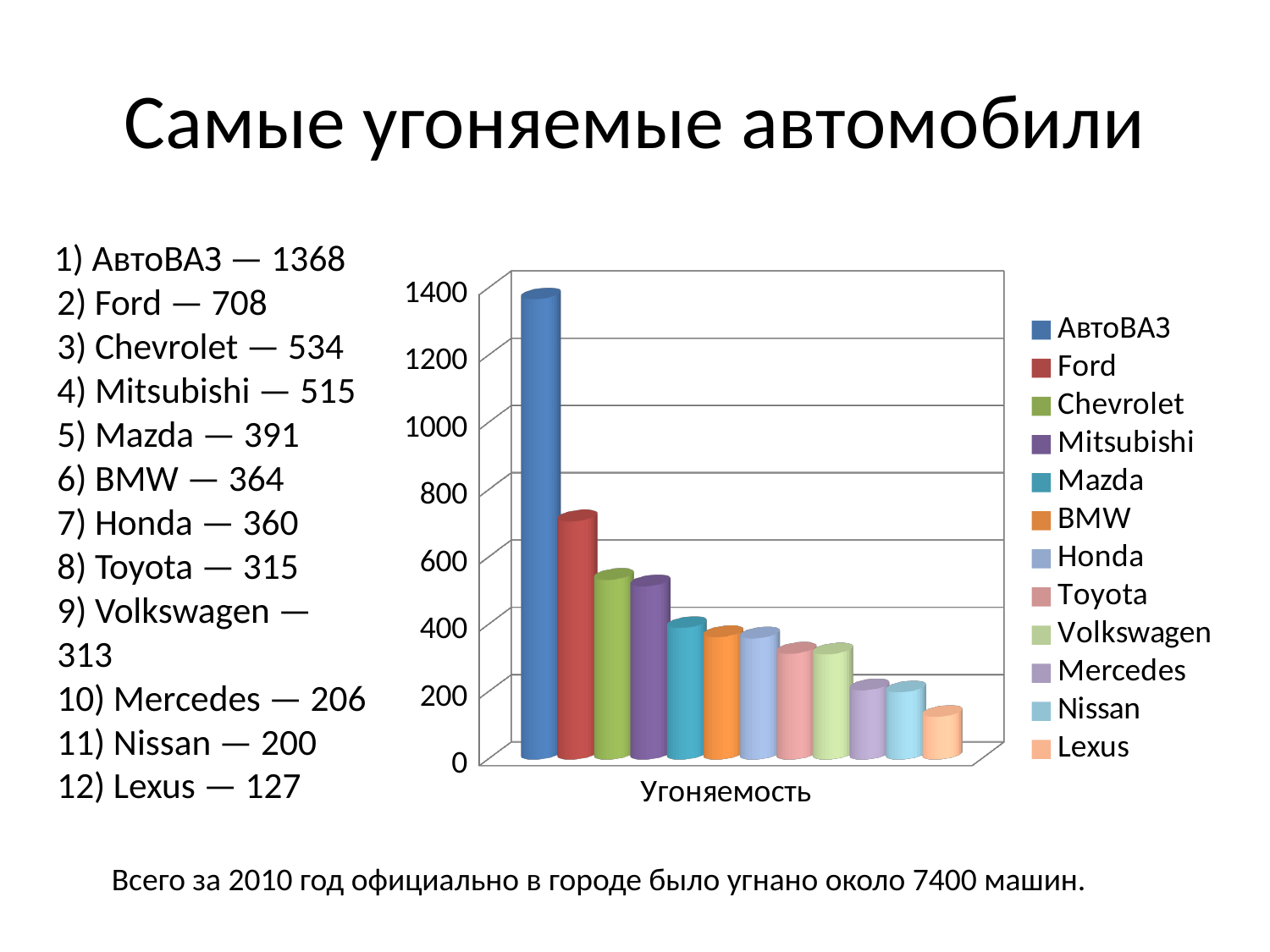
What kind of chart is shown on the slide? bar chart What is the value for Lexus? 127 Which is larger, the value for Chevrolet or the value for Mazda? Chevrolet What is the value for АвтоВАЗ? 1368 Is the value for Ford greater or less than 600? greater Is the value for Nissan greater or less than 400? less How many series does the chart legend list? 12 Which car brand has the highest value in the chart? АвтоВАЗ Which car brand has the lowest value in the chart? Lexus What is the value for Ford? 708 What is the category label shown on the x axis of the chart? Угоняемость What is the difference between the values for АвтоВАЗ and Ford? 660